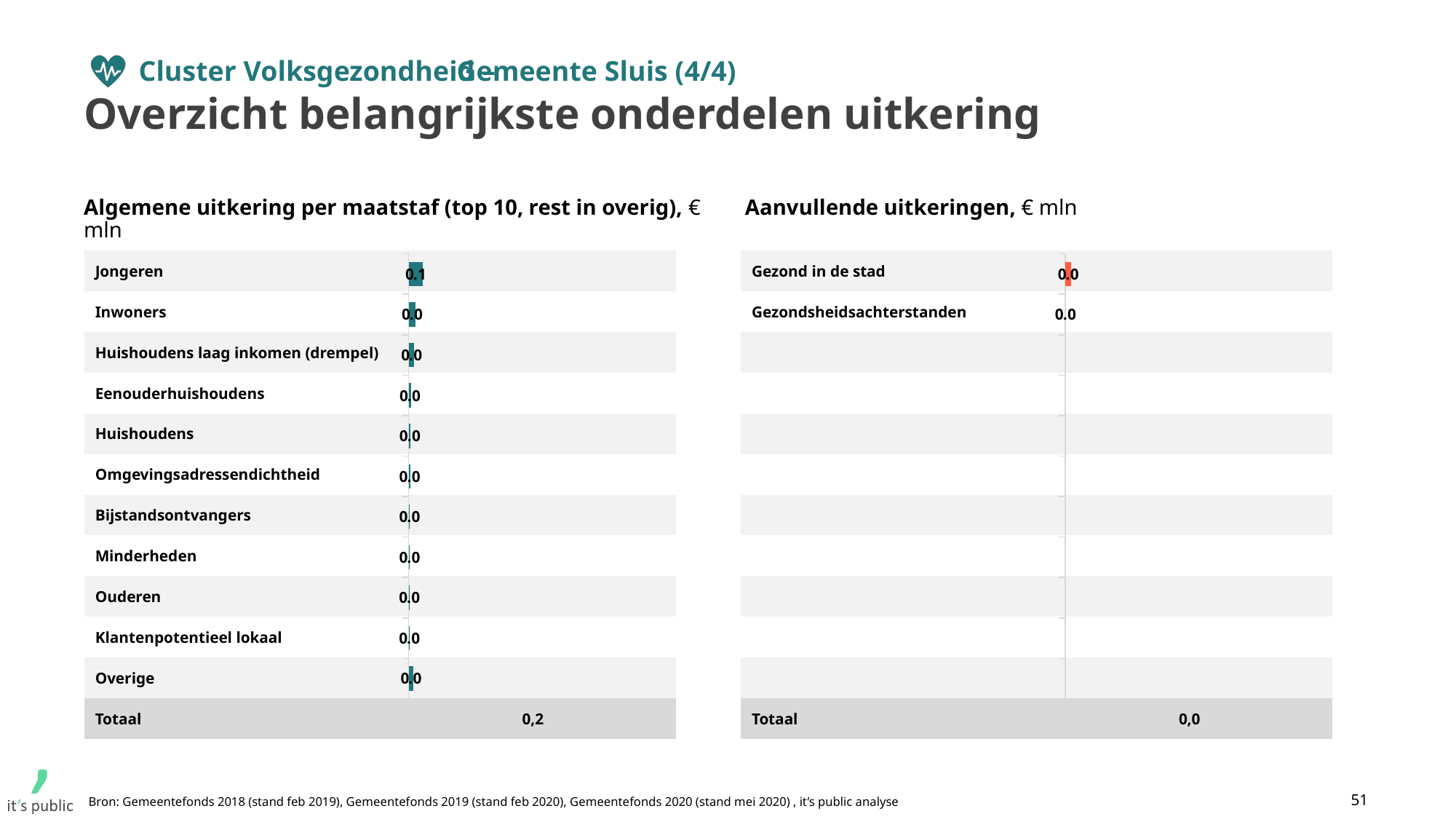
In the chart 'Algemene uitkering per maatstaf', what kind of chart is used? Bar chart In the chart 'Aanvullende uitkeringen', what is the value for Gezondsheidsachterstanden? 0.0 In the chart 'Aanvullende uitkeringen', what is the value for Gezond in de stad? 0.0 In the chart 'Aanvullende uitkeringen', what is the Totaal value? 0,0 In the chart 'Algemene uitkering per maatstaf', what is the value for Jongeren? 0.1 In the chart 'Aanvullende uitkeringen', how many named categories are listed above the Totaal row? 2 In the chart 'Algemene uitkering per maatstaf', which category has the highest value? Jongeren In the chart 'Algemene uitkering per maatstaf', what is the value for Overige? 0.0 In the chart 'Algemene uitkering per maatstaf', what is the Totaal value? 0,2 In the chart 'Algemene uitkering per maatstaf', what unit is stated in the chart title? € mln In the chart 'Algemene uitkering per maatstaf', how many categories are listed above the Totaal row? 11 In the chart 'Algemene uitkering per maatstaf', what is the value for Inwoners? 0.0